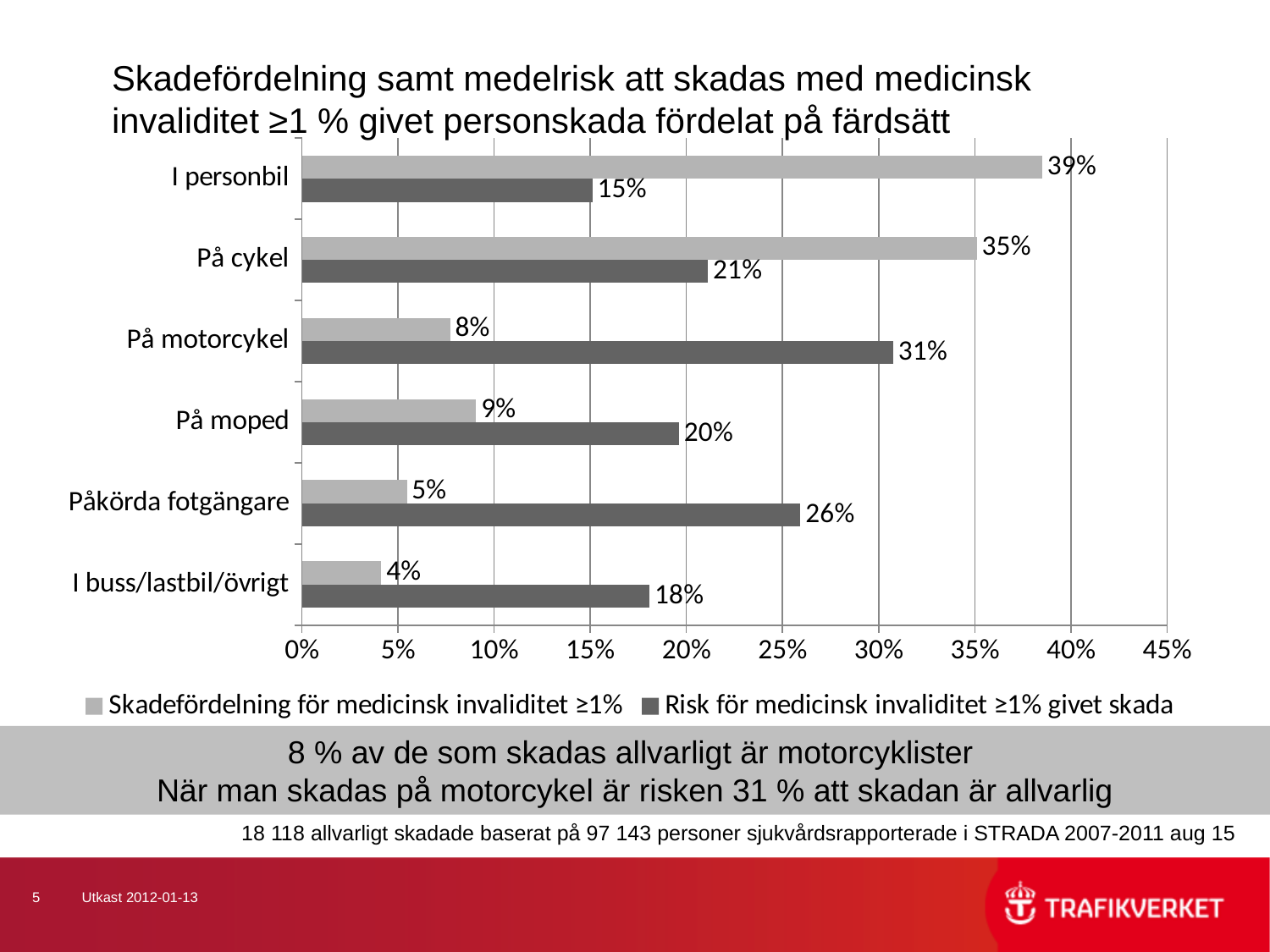
What is the value of "Risk för medicinsk invaliditet ≥1% givet skada" for "På motorcykel"? 31% Which category has the lowest value for "Risk för medicinsk invaliditet ≥1% givet skada"? I personbil What is the value of "Risk för medicinsk invaliditet ≥1% givet skada" for "Påkörda fotgängare"? 26% What kind of chart is shown on the slide? Bar chart How many categories are shown on the chart? 6 Which category has the lowest value for "Skadefördelning för medicinsk invaliditet ≥1%"? I buss/lastbil/övrigt Which is larger for "På moped": "Skadefördelning för medicinsk invaliditet ≥1%" or "Risk för medicinsk invaliditet ≥1% givet skada"? Risk för medicinsk invaliditet ≥1% givet skada What is the value of "Skadefördelning för medicinsk invaliditet ≥1%" for "I personbil"? 39% Which category has the highest value for "Skadefördelning för medicinsk invaliditet ≥1%"? I personbil What is the difference between the two series values for "På cykel"? 14% How many series does the legend list? 2 What is the maximum value shown on the x axis? 45%